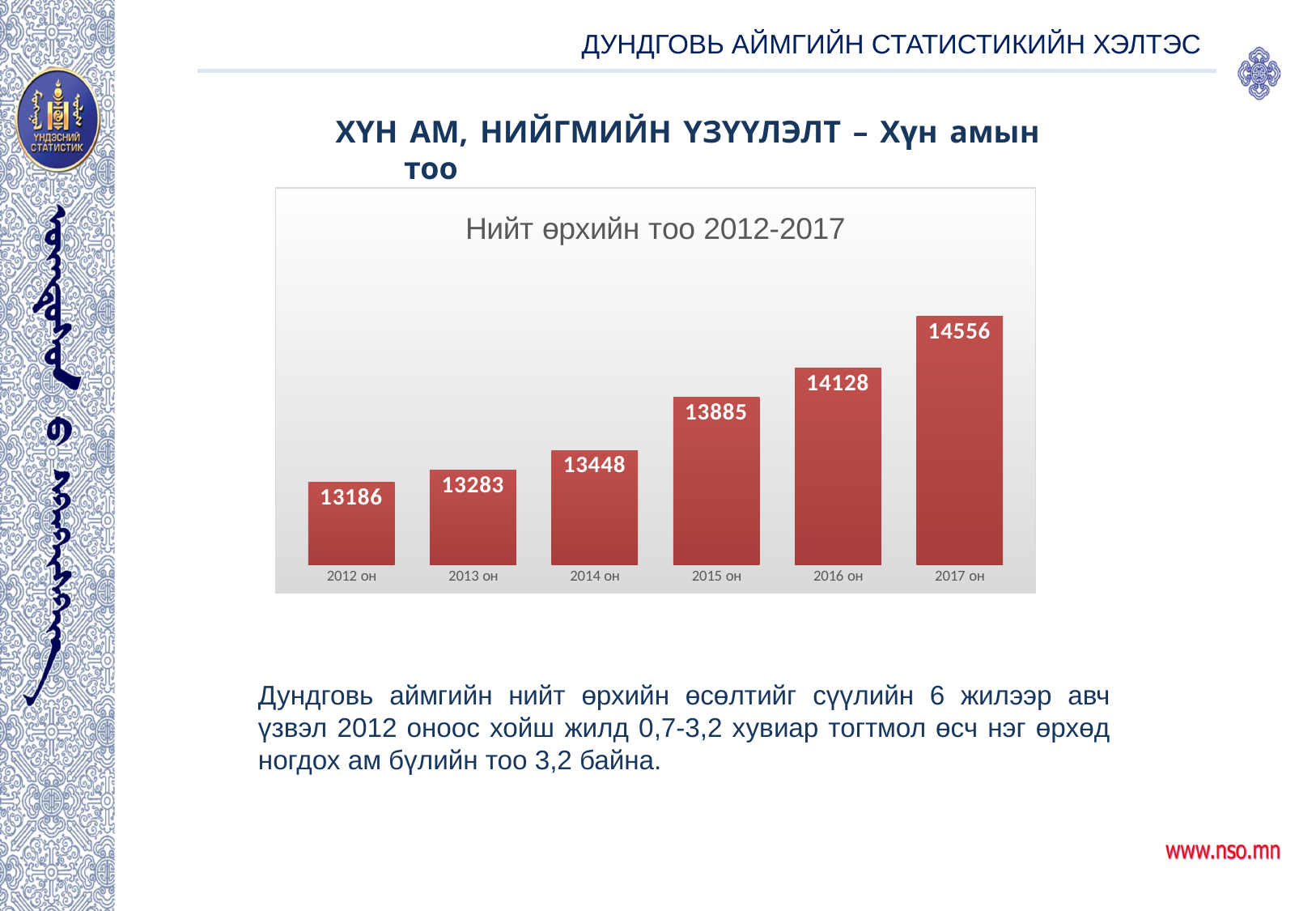
What is the title of the chart? Нийт өрхийн тоо 2012-2017 Which year has the highest value? 2017 он How many years are shown on the x axis? 6 What is the value for 2017 он? 14556 Which year has the lowest value? 2012 он What is the value for 2012 он? 13186 What is the value for 2015 он? 13885 What is the difference between the values for 2017 он and 2012 он? 1370 Which is larger, the value for 2014 он or the value for 2013 он? 2014 он What kind of chart is this? bar chart What is the difference between the values for 2016 он and 2015 он? 243 Do the values rise or fall from 2012 он to 2017 он? rise